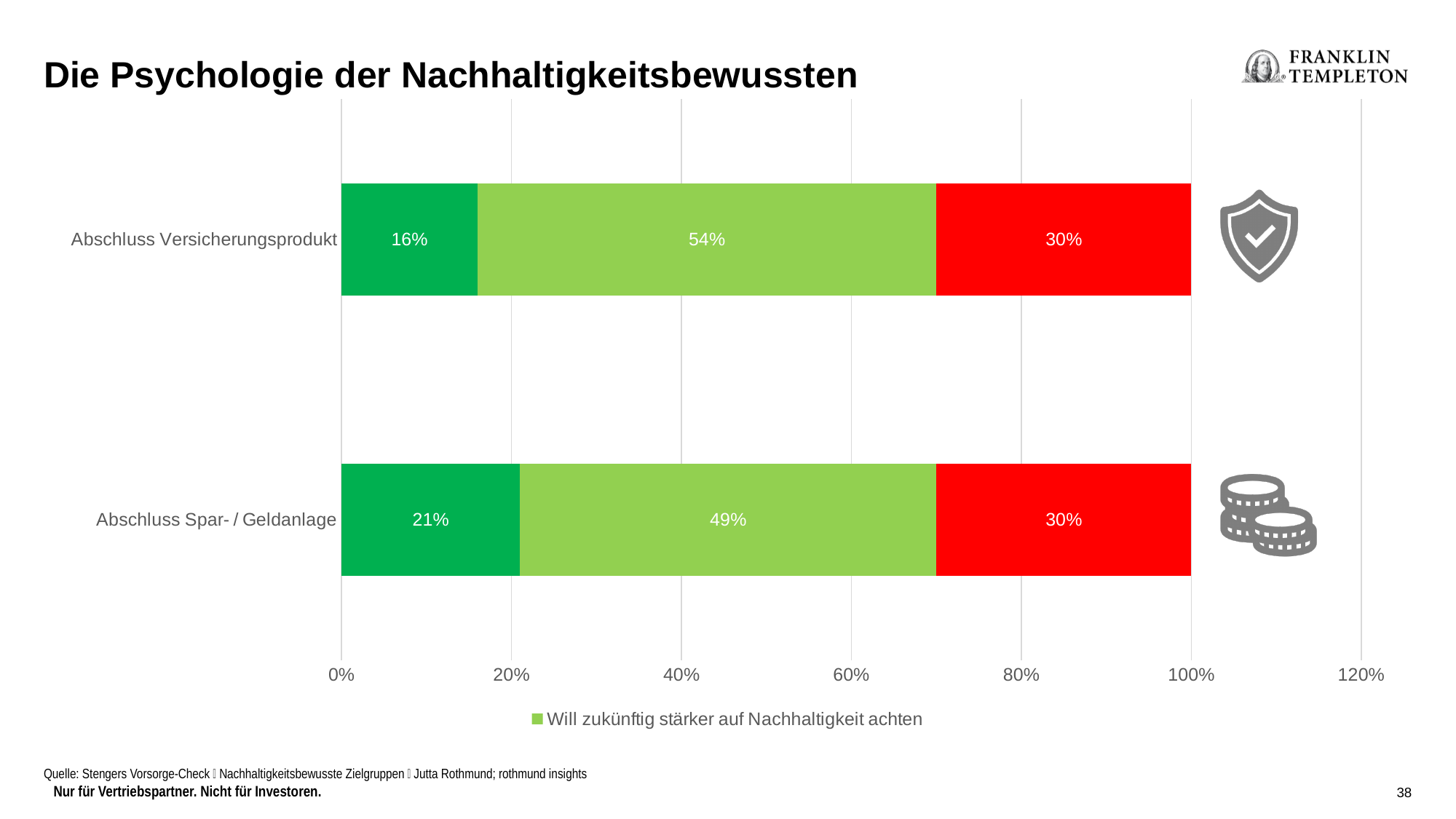
Which category has the higher value for the light green segment "Will zukünftig stärker auf Nachhaltigkeit achten"? Abschluss Versicherungsprodukt What is the value of the red (rightmost) segment for "Abschluss Versicherungsprodukt"? 30% What is the value of the light green segment ("Will zukünftig stärker auf Nachhaltigkeit achten") for "Abschluss Versicherungsprodukt"? 54% What is the value of the light green segment ("Will zukünftig stärker auf Nachhaltigkeit achten") for "Abschluss Spar- / Geldanlage"? 49% What is the difference between the dark green (leftmost) segment values of "Abschluss Spar- / Geldanlage" and "Abschluss Versicherungsprodukt"? 5% What is the total of the stacked bar for "Abschluss Versicherungsprodukt"? 100% What is the legend entry shown below the chart? Will zukünftig stärker auf Nachhaltigkeit achten Is the dark green (leftmost) segment larger for "Abschluss Versicherungsprodukt" or for "Abschluss Spar- / Geldanlage"? Abschluss Spar- / Geldanlage How many series does the legend list? 1 What is the value of the dark green (leftmost) segment for "Abschluss Spar- / Geldanlage"? 21% What kind of chart is shown on the slide? Stacked bar chart How many categories are plotted on the chart? 2